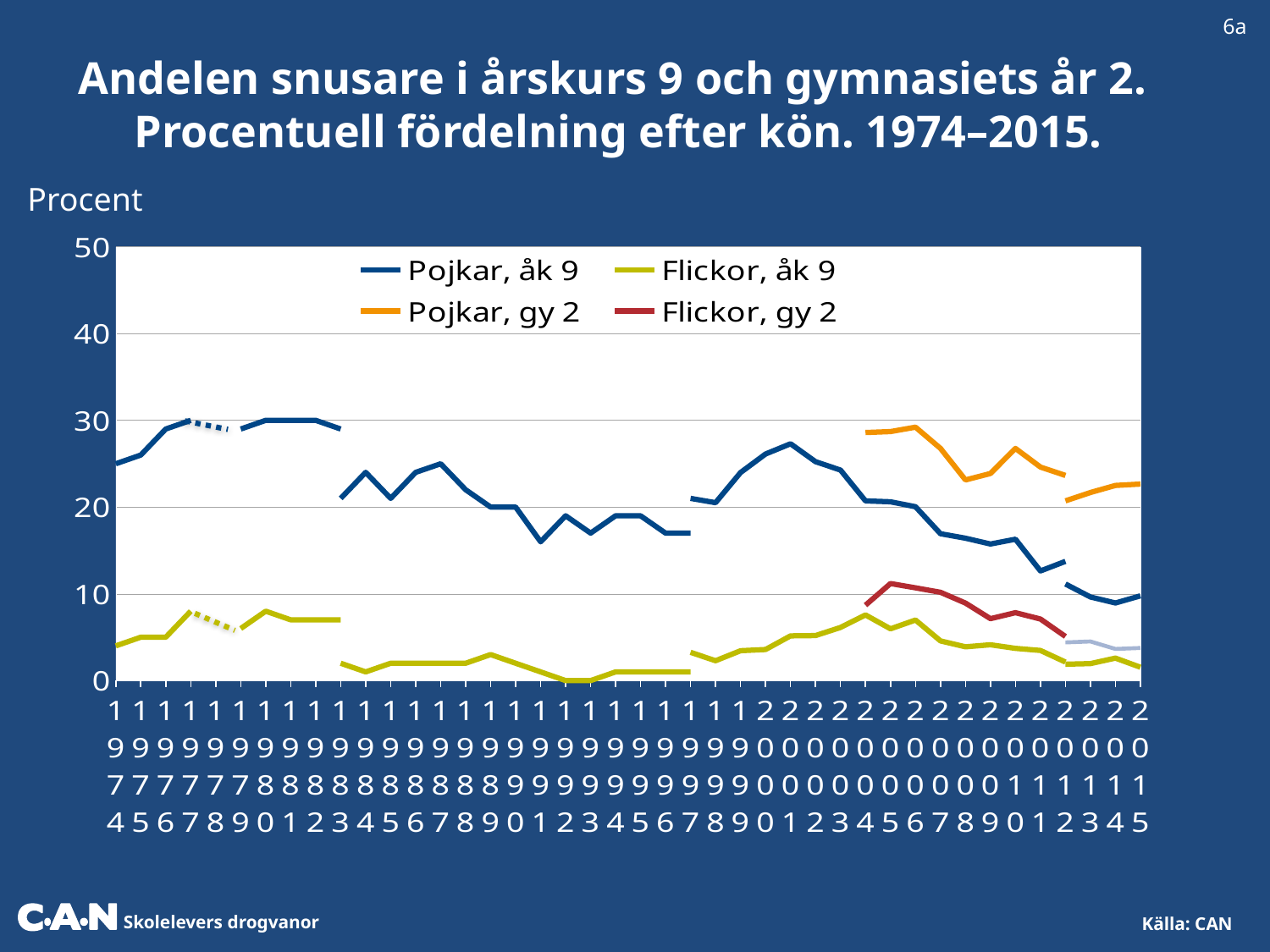
Which series is drawn in orange? Pojkar, gy 2 How many series does the legend list? 4 Is the value for Pojkar, åk 9 in 1974 greater or less than 20? greater What kind of chart is shown on the slide? line chart Which series has the highest value in 2004? Pojkar, gy 2 Does the Flickor, gy 2 line rise or fall from 2005 to 2012? fall Is the value for Pojkar, gy 2 in 2004 greater or less than 20? greater In 2010, which is larger: Pojkar, gy 2 or Flickor, gy 2? Pojkar, gy 2 Is the value for Flickor, gy 2 in 2012 greater or less than 10? less What is the highest value shown on the vertical axis? 50